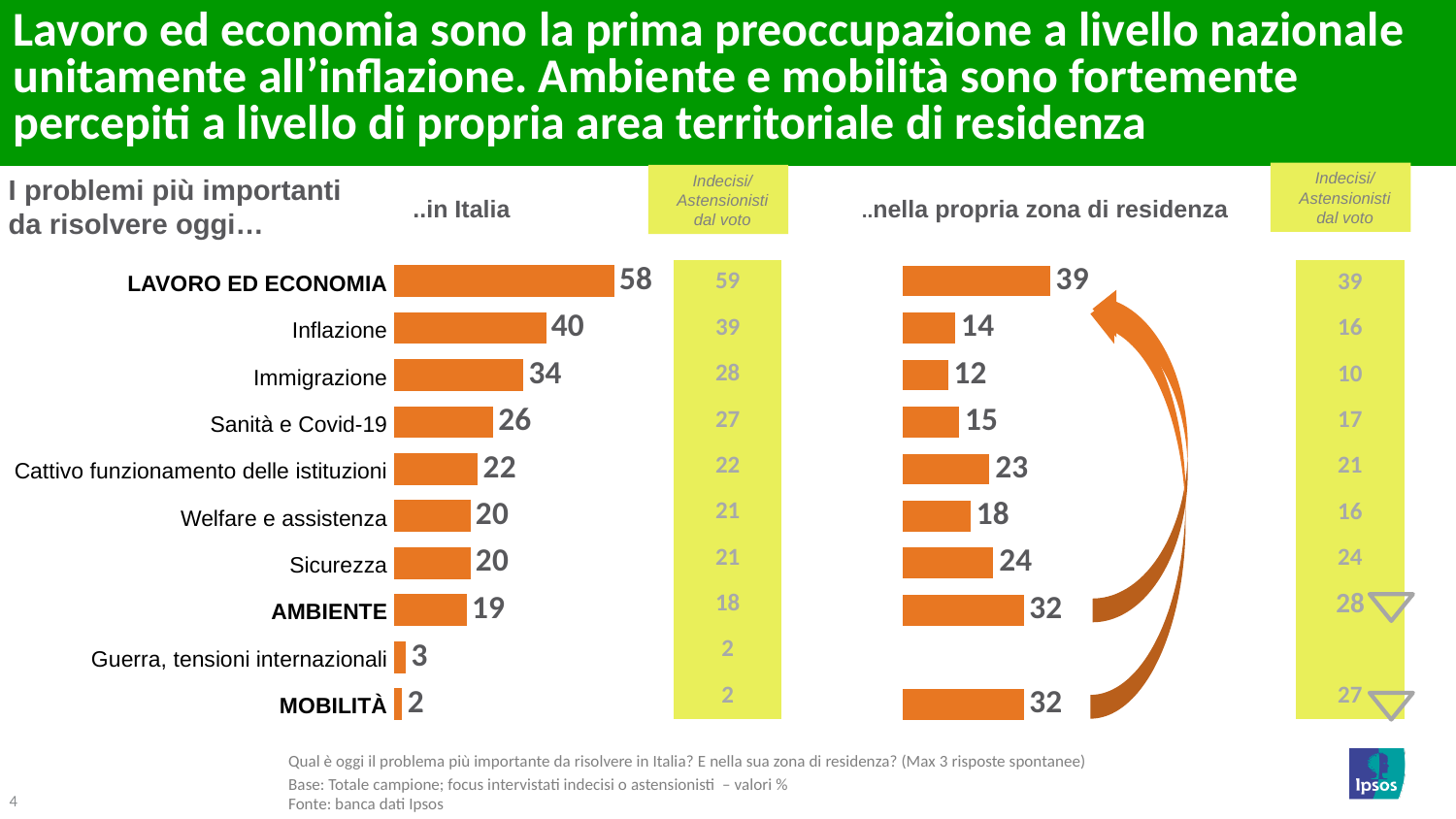
What kind of chart is the "..in Italia" chart? Bar chart How many categories are listed in the "..in Italia" chart? 10 In the "..in Italia" chart, which category has the lowest value? MOBILITÀ In the "..nella propria zona di residenza" chart, which category has the lowest value? Immigrazione In the "..nella propria zona di residenza" chart, what is the difference between the values for LAVORO ED ECONOMIA and Sicurezza? 15 In the "..in Italia" chart, which category has the highest value? LAVORO ED ECONOMIA In the "..nella propria zona di residenza" chart, which is larger: the value for Cattivo funzionamento delle istituzioni or the value for Welfare e assistenza? Cattivo funzionamento delle istituzioni In the "..in Italia" chart, which is larger: the value for Immigrazione or the value for Sanità e Covid-19? Immigrazione In the "..nella propria zona di residenza" chart, what is the value for AMBIENTE? 32 In the "..in Italia" chart, what is the value for Guerra, tensioni internazionali? 3 In the "..in Italia" chart, what is the value for Inflazione? 40 In the "..in Italia" chart, what is the difference between the values for LAVORO ED ECONOMIA and Inflazione? 18